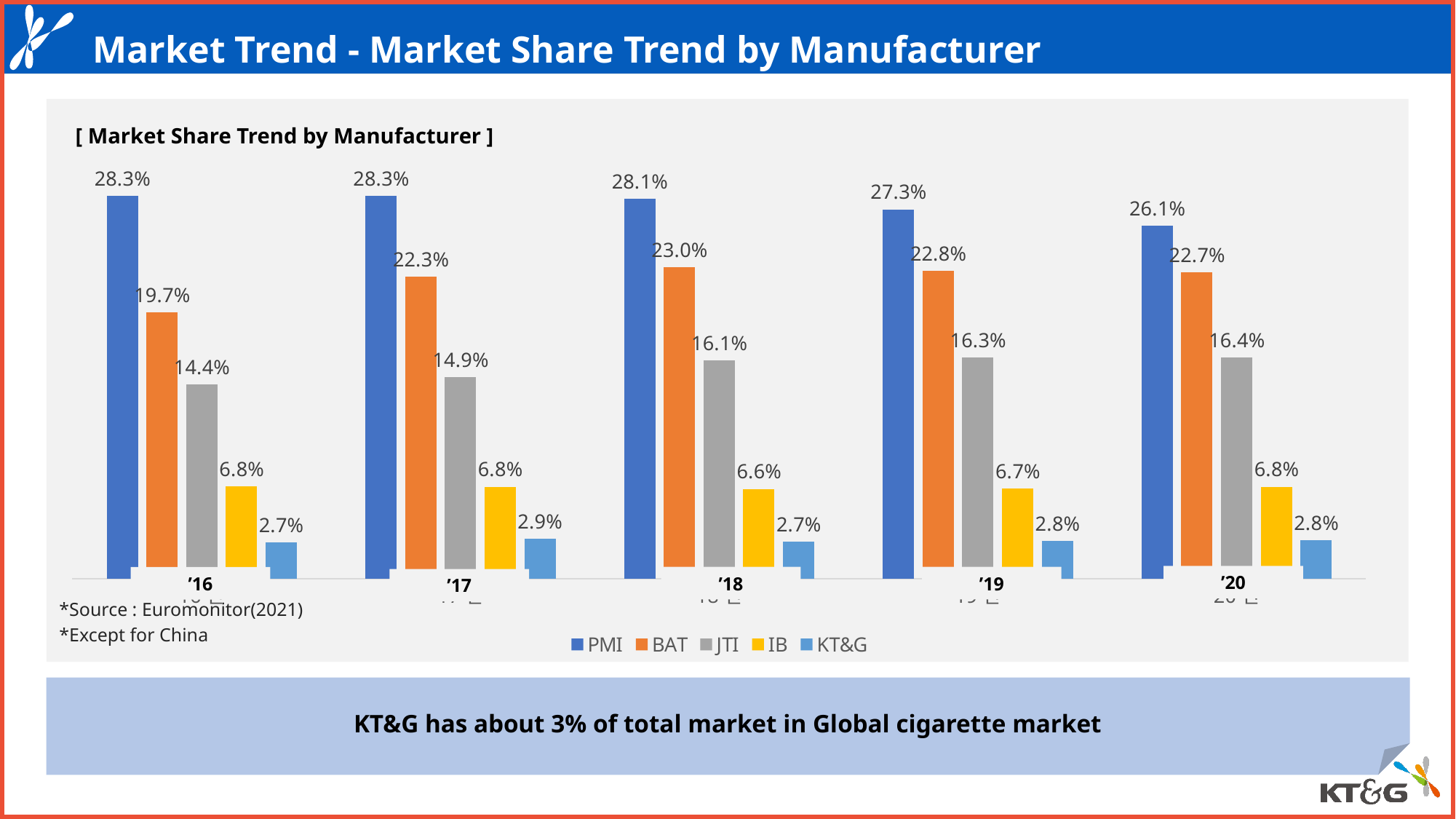
Which manufacturer had the lowest market share in '20? KT&G How many series does the legend list? 5 What was BAT's market share in '18? 23.0% What was KT&G's market share in '17? 2.9% What was PMI's market share in '16? 28.3% Does PMI's market share rise or fall from '16 to '20? Fall What was JTI's market share in '20? 16.4% Which manufacturer had the highest market share in '19? PMI Which was larger in '18, JTI's market share or IB's market share? JTI What is the difference between PMI's and BAT's market share in '20? 3.4% How many years are shown on the x axis? 5 What kind of chart is shown on the slide? Bar chart